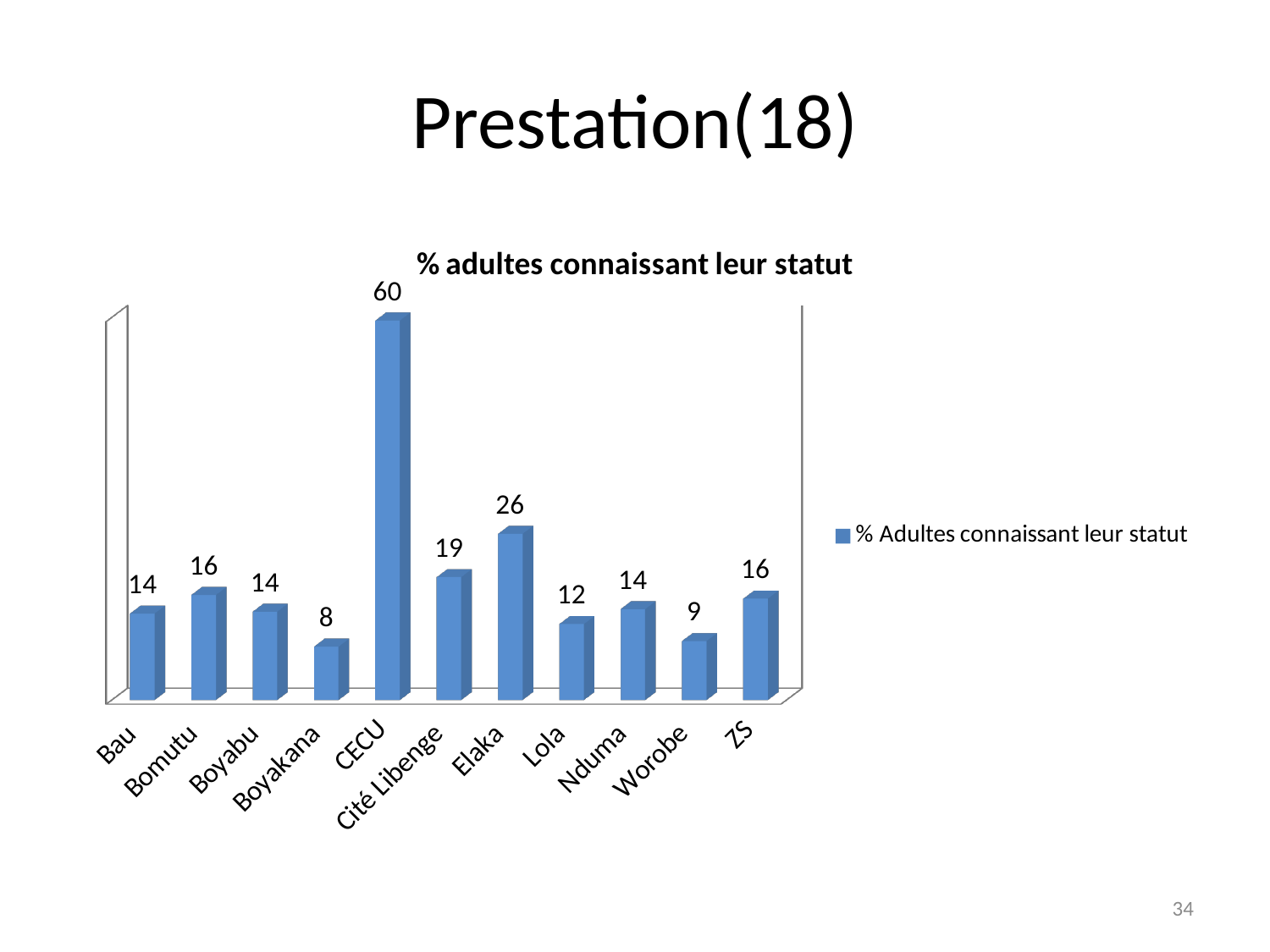
What is the difference between the values for CECU and Elaka? 34 Which is larger, the value for Lola or the value for Worobe? Lola How many series does the legend list? 1 Which category has the highest value? CECU What is the title of the chart? % adultes connaissant leur statut What is the value for Cité Libenge? 19 What kind of chart is shown? bar chart What is the value for Elaka? 26 What is the value for CECU? 60 What is the value for Boyakana? 8 How many categories are shown on the x axis? 11 Which category has the lowest value? Boyakana